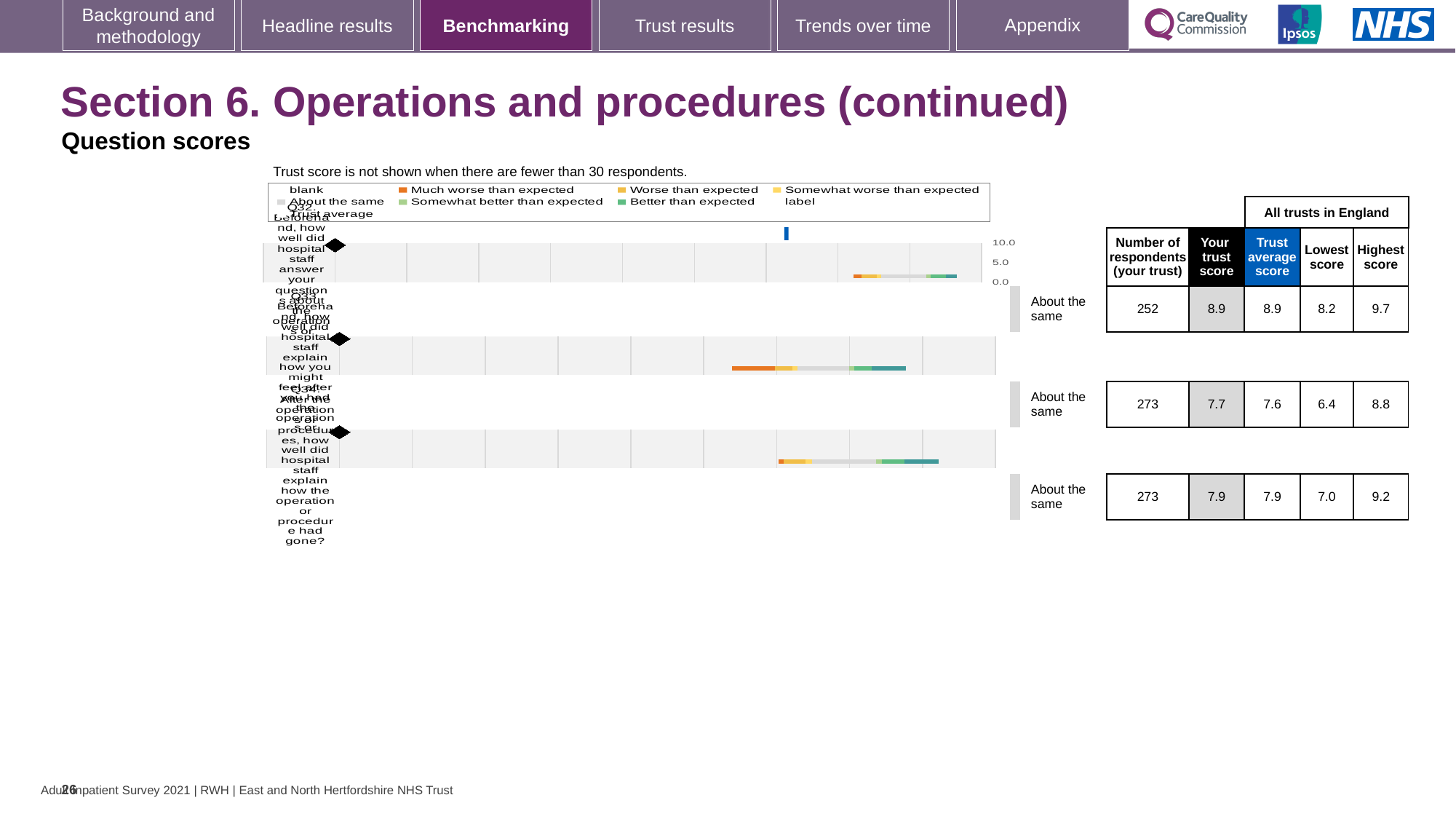
What kind of chart is used to show the question scores? Bar chart In the table, what is the lowest score among all trusts in England for the second question row? 6.4 Which question row has the lowest 'Lowest score' value in the table? The second row (6.4) In the table, what is the number of respondents for the first question row? 252 What is the difference between the highest score and the lowest score for the first question row? 1.5 How many question rows are shown in the chart and table? 3 In the table, what is 'Your trust score' for the first question row? 8.9 In the table, what is the highest score among all trusts in England for the third question row? 9.2 Which question row has the highest 'Your trust score' in the table? The first row (8.9) For the second question row, is 'Your trust score' larger or smaller than the trust average score? Larger (7.7 vs 7.6) What is the maximum value shown on the chart's score axis? 10.0 What benchmark category is shown next to each of the three question rows? About the same